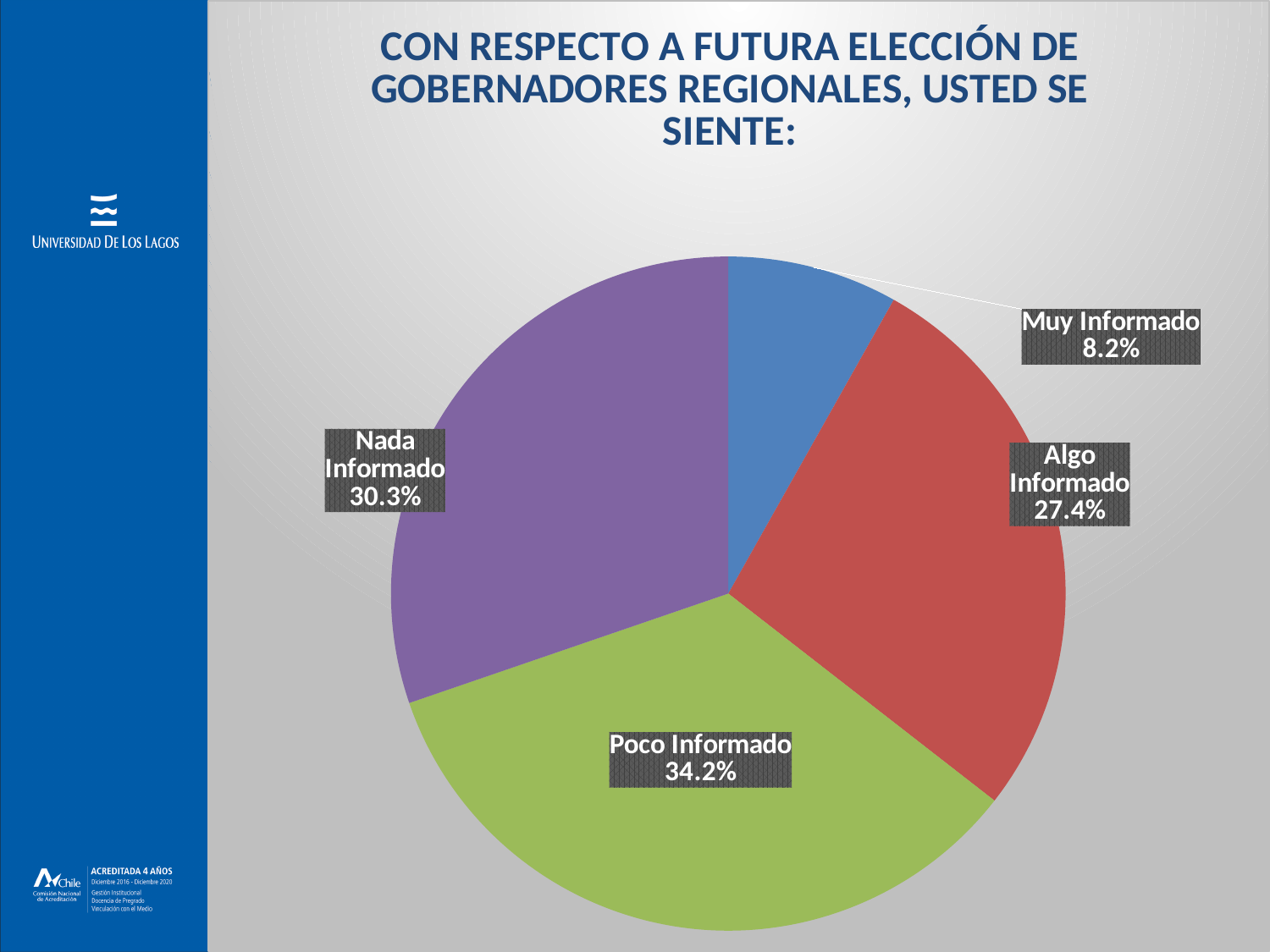
Which is larger, the share for 'Nada Informado' or the share for 'Algo Informado'? Nada Informado Which category has the smallest share of the pie? Muy Informado What percentage of respondents said they feel 'Algo Informado'? 27.4% What percentage of respondents said they feel 'Poco Informado'? 34.2% What type of chart is shown on the slide? Pie chart What colour is the 'Poco Informado' slice? Green What percentage of respondents said they feel 'Muy Informado'? 8.2% What percentage of respondents said they feel 'Nada Informado'? 30.3% What is the difference in percentage points between 'Algo Informado' and 'Muy Informado'? 19.2 What is the difference in percentage points between 'Poco Informado' and 'Nada Informado'? 3.9 How many categories are shown in the pie chart? 4 Which category has the largest share of the pie? Poco Informado